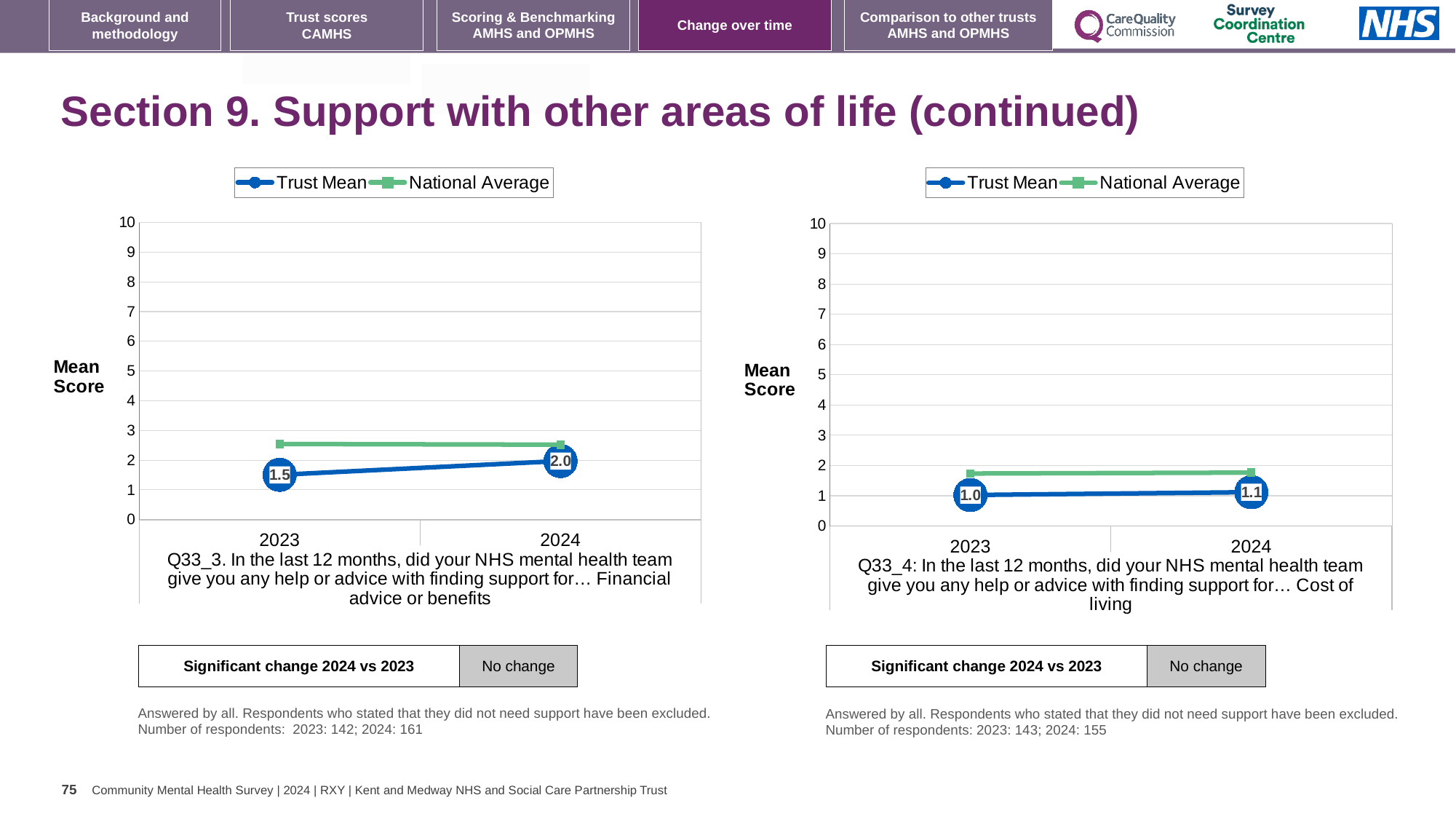
In the right chart (Q33_4, Cost of living), what is the Trust Mean for 2024? 1.1 In the left chart (Q33_3, Financial advice or benefits), by how much did the Trust Mean change from 2023 to 2024? 0.5 In the left chart (Q33_3, Financial advice or benefits), is the National Average for 2023 greater or less than 2? greater In the right chart (Q33_4, Cost of living), what is the Trust Mean for 2023? 1.0 How many years are shown on the x axis of the right chart (Q33_4, Cost of living)? 2 In the left chart (Q33_3, Financial advice or benefits), what is the Trust Mean for 2024? 2.0 How many series does the legend of the left chart (Q33_3, Financial advice or benefits) list? 2 In the left chart (Q33_3, Financial advice or benefits), is the Trust Mean higher in 2023 or 2024? 2024 In the left chart (Q33_3, Financial advice or benefits), does the Trust Mean rise or fall from 2023 to 2024? rise In the right chart (Q33_4, Cost of living), is the National Average for 2024 greater or less than 2? less What kind of chart is the right chart (Q33_4, Cost of living)? line chart In the left chart (Q33_3, Financial advice or benefits), what is the Trust Mean for 2023? 1.5